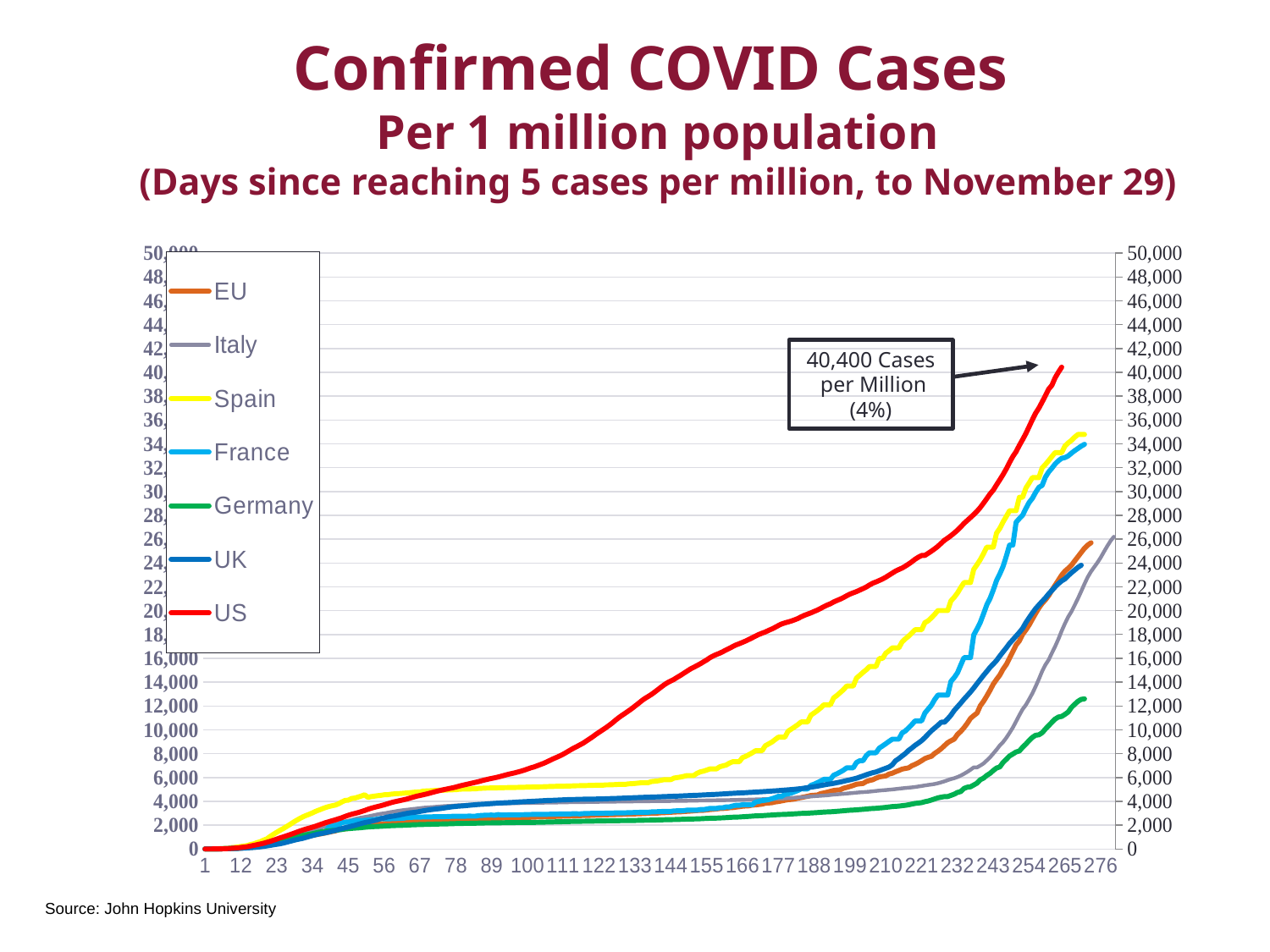
Does the US line rise or fall as the days increase along the x axis? rise What colour is the US line in the legend? red Which series reaches the highest value at the right end of the chart? US How many series does the legend list? 7 What percentage is shown in parentheses in the annotation box? 4% According to the annotation, how many cases per million does the US line reach at its end? 40,400 At the right end of the chart, which is higher: Spain or Germany? Spain Is the value for the US at day 100 greater or less than 10,000? less Which series has the lowest value at the right end of the chart? Germany Is the final value for Germany greater or less than 14,000? less What kind of chart is shown on the slide? line chart Is the final value for Spain greater or less than 30,000? greater